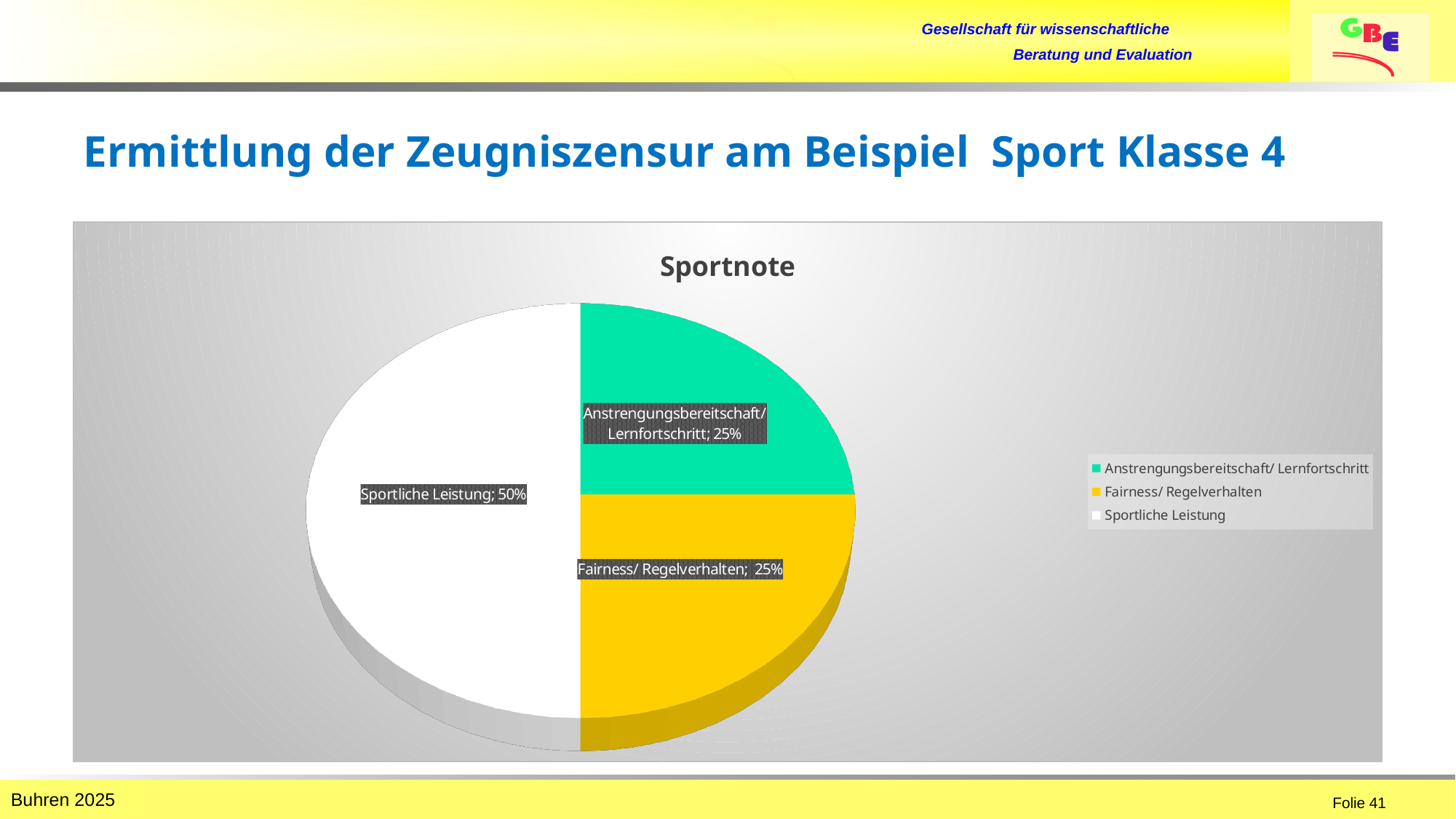
What share of the pie does Fairness/ Regelverhalten have? 25% Which is larger: the share of Sportliche Leistung or the share of Anstrengungsbereitschaft/ Lernfortschritt? Sportliche Leistung What is the title of the chart? Sportnote What share of the pie does Sportliche Leistung have? 50% What is the difference between the share of Sportliche Leistung and the share of Fairness/ Regelverhalten? 25% What share of the pie does Anstrengungsbereitschaft/ Lernfortschritt have? 25% What is the combined share of Anstrengungsbereitschaft/ Lernfortschritt and Fairness/ Regelverhalten? 50% How many entries does the legend list? 3 Which category has the largest slice of the pie? Sportliche Leistung What kind of chart is shown on the slide? pie chart How many slices does the pie chart have? 3 What colour is the Fairness/ Regelverhalten slice? yellow